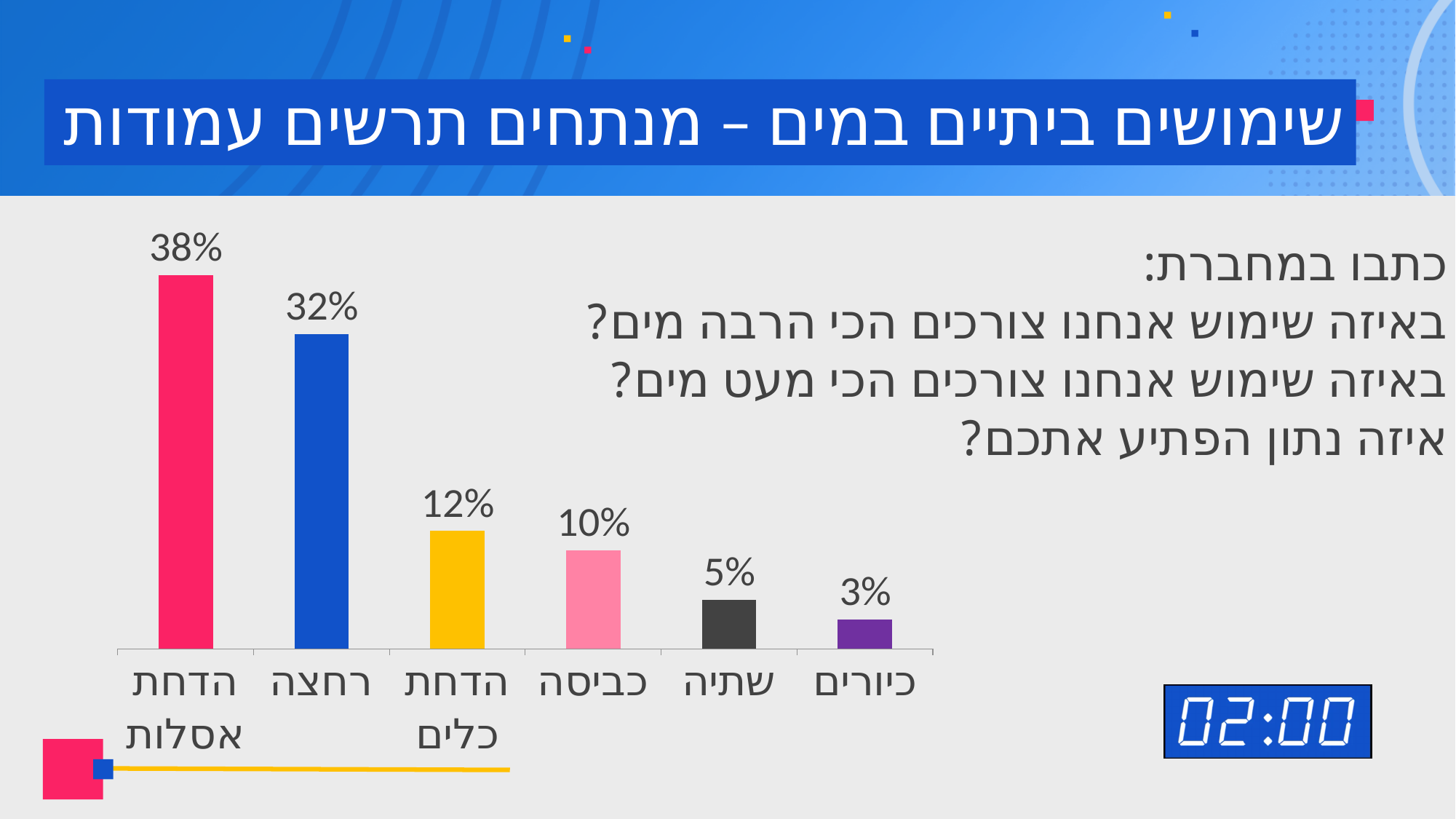
What is the difference between the values for הדחת אסלות and רחצה? 6% What is the value for כביסה? 10% What kind of chart is shown on the slide? bar chart How many categories are shown in the chart? 6 What is the difference between the values for הדחת כלים and שתיה? 7% Which is larger, the value for כביסה or the value for שתיה? כביסה What is the value for רחצה? 32% What is the value for כיורים? 3% Which category has the highest value? הדחת אסלות Which category has the lowest value? כיורים Do the values rise or fall from left to right along the x axis? fall What is the value for הדחת אסלות? 38%